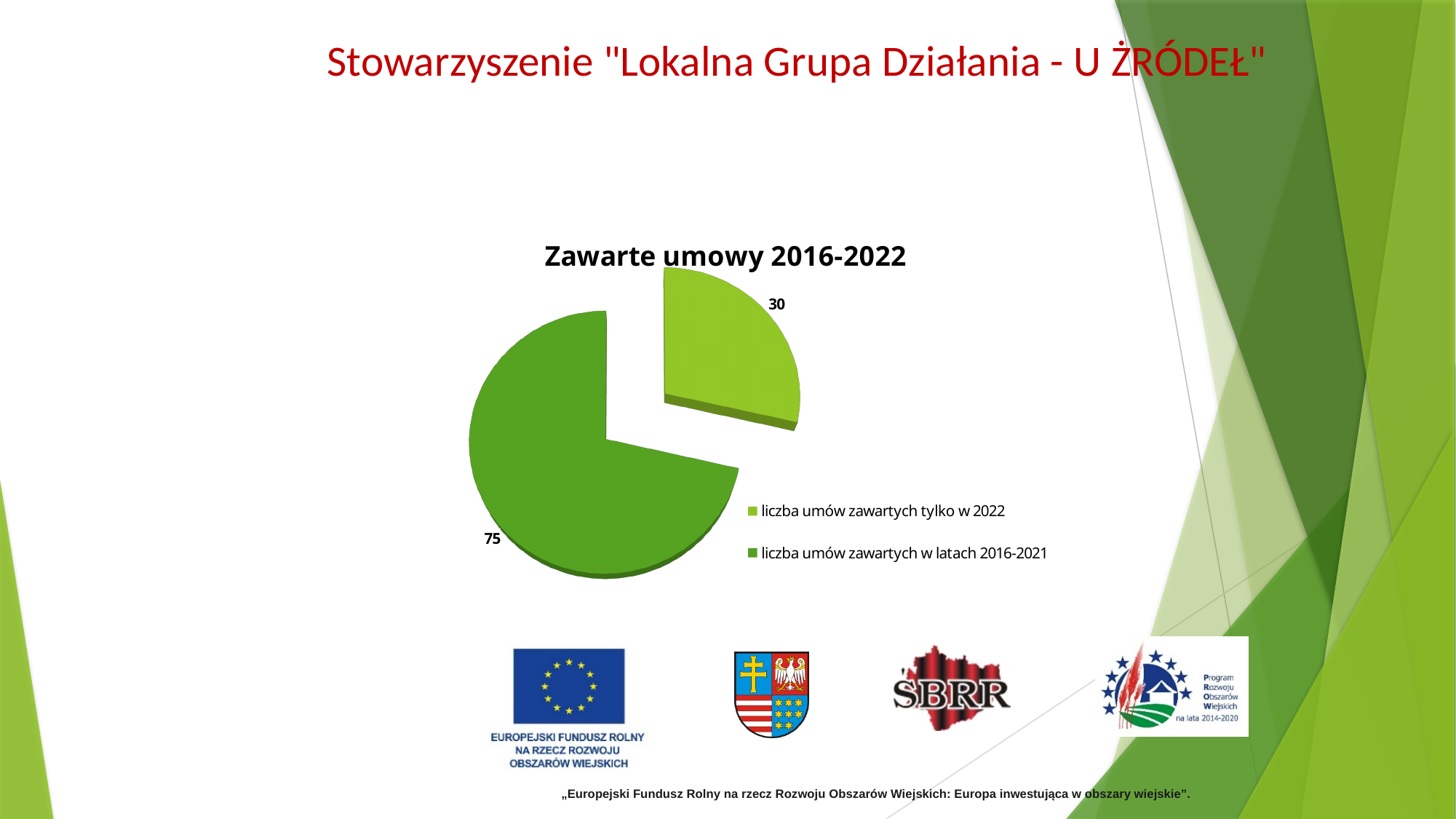
What is the value for "liczba umów zawartych w latach 2016-2021"? 75 How many entries does the legend list? 2 What is the total of all slices in the pie chart? 105 What is the title of the chart? Zawarte umowy 2016-2022 Which category has the largest slice of the pie? liczba umów zawartych w latach 2016-2021 Which is larger: the value for "liczba umów zawartych tylko w 2022" or for "liczba umów zawartych w latach 2016-2021"? liczba umów zawartych w latach 2016-2021 How many slices does the pie chart have? 2 Which category has the smallest slice of the pie? liczba umów zawartych tylko w 2022 What is the value for "liczba umów zawartych tylko w 2022"? 30 What kind of chart is shown on the slide? pie chart What is the difference between the number of contracts concluded in 2016-2021 and those concluded only in 2022? 45